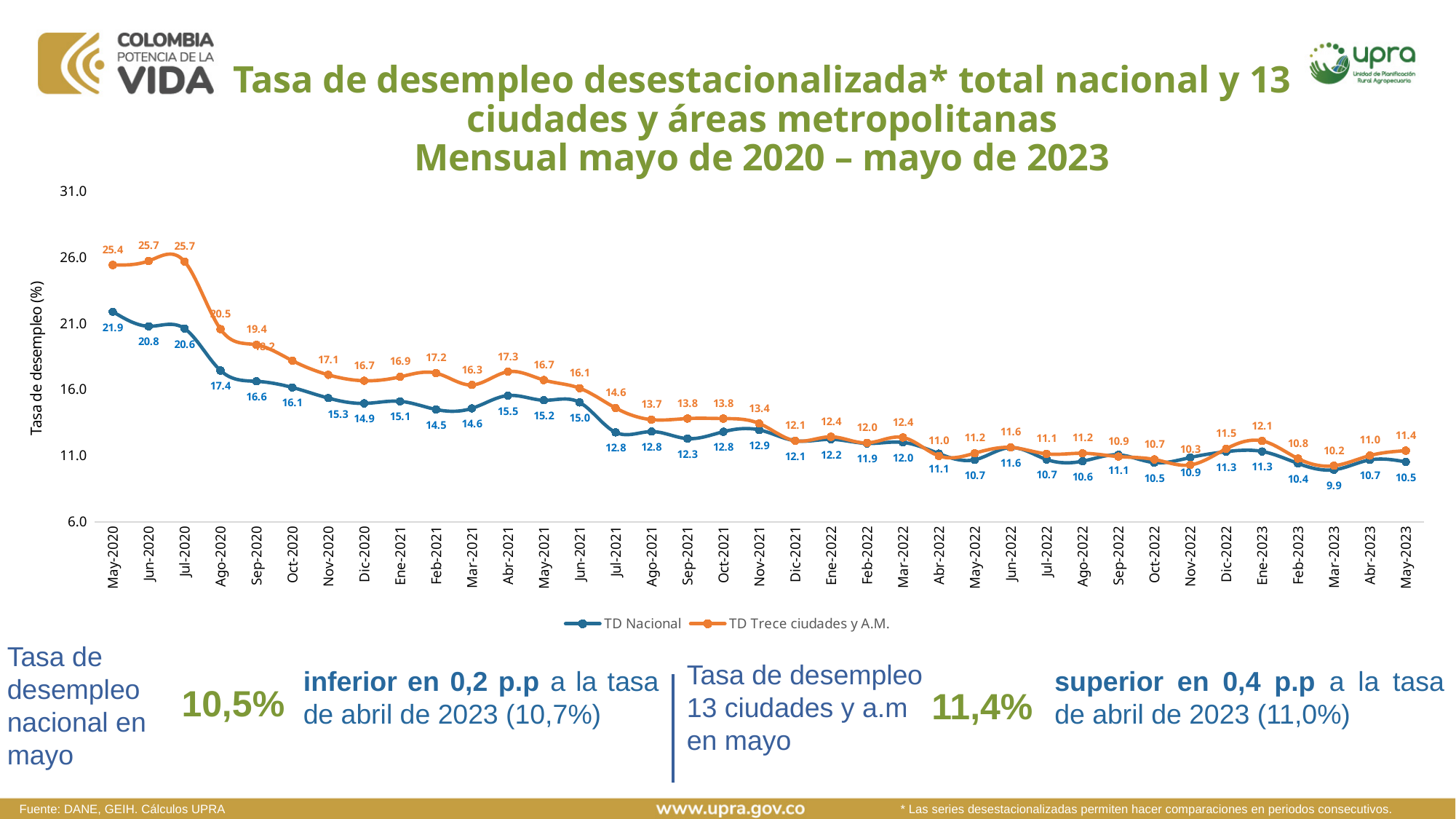
Which is larger for TD Nacional: the value in Mar-2021 or in Abr-2021? Abr-2021 Is the value of TD Nacional in Ago-2020 greater or less than 16.0? greater What is the value of TD Nacional in Mar-2023? 9.9 What is the value of TD Trece ciudades y A.M. in May-2023? 11.4 What is the difference between TD Trece ciudades y A.M. and TD Nacional in May-2023? 0.9 What kind of chart is shown on the slide? Line chart In which month does the TD Trece ciudades y A.M. series reach its lowest value? Mar-2023 How many monthly points are plotted along the x axis? 37 In which month does the TD Nacional series reach its lowest value? Mar-2023 How many series does the legend list? 2 In which month does the TD Nacional series reach its highest value? May-2020 What is the value of TD Nacional in May-2020? 21.9